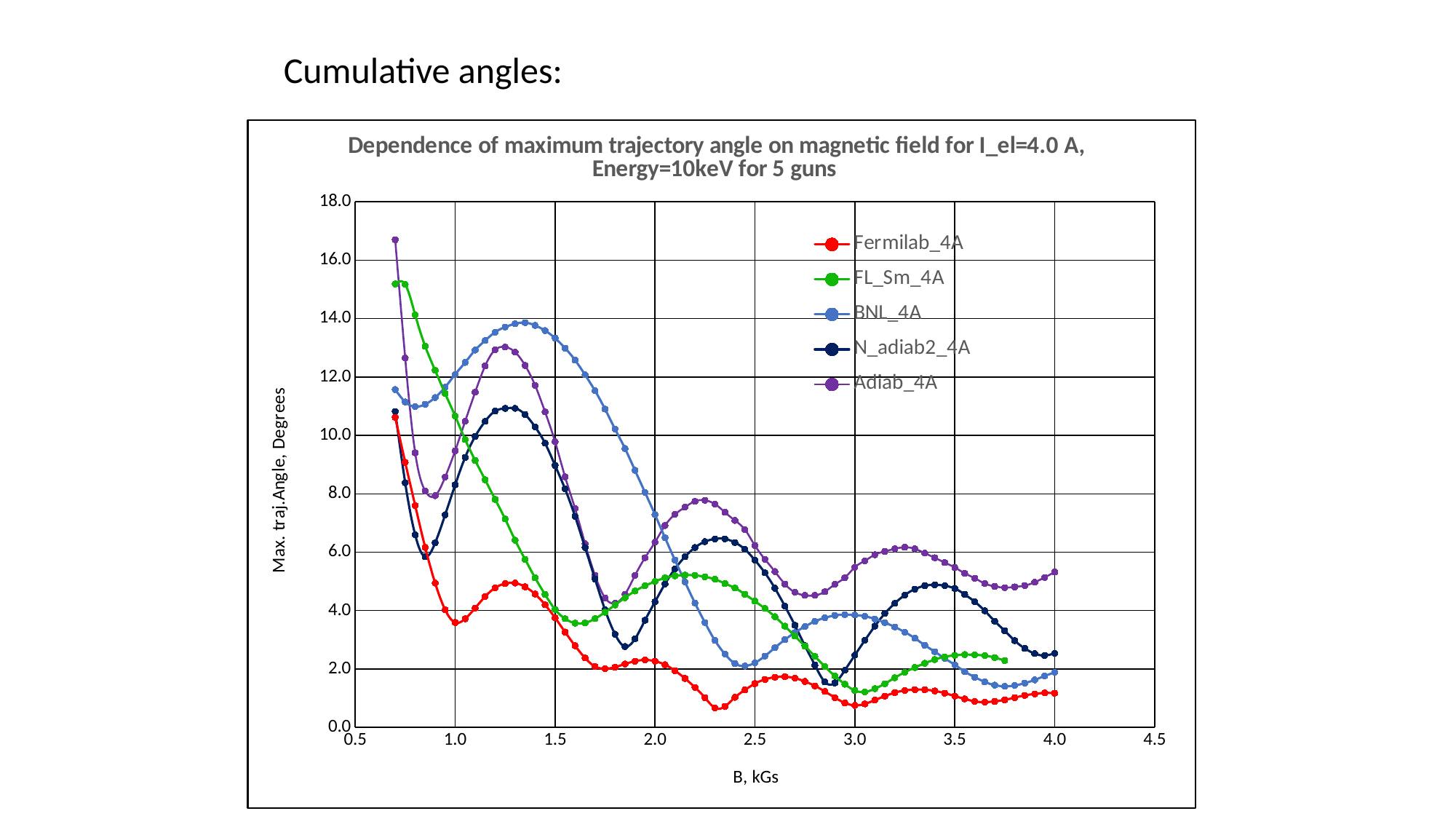
Which series has the highest value at B=0.7 kGs? Adiab_4A At B=1.3 kGs, which series has the larger value, BNL_4A or Fermilab_4A? BNL_4A Overall, does the Fermilab_4A series rise or fall as B increases from 0.7 to 4.0 kGs? fall Is the value for Fermilab_4A at B=2.3 kGs greater or less than 2.0? less Is the value for Adiab_4A at B=0.7 kGs greater or less than 16.0? greater At B=3.0 kGs, which series has the larger value, Adiab_4A or FL_Sm_4A? Adiab_4A Is the peak value of BNL_4A near B=1.35 kGs greater or less than 12.0? greater Which series has the lowest value at B=4.0 kGs? Fermilab_4A How many series does the legend list? 5 What is the label of the y axis? Max. traj.Angle, Degrees What kind of chart is shown on the slide? line chart What is the label of the x axis? B, kGs